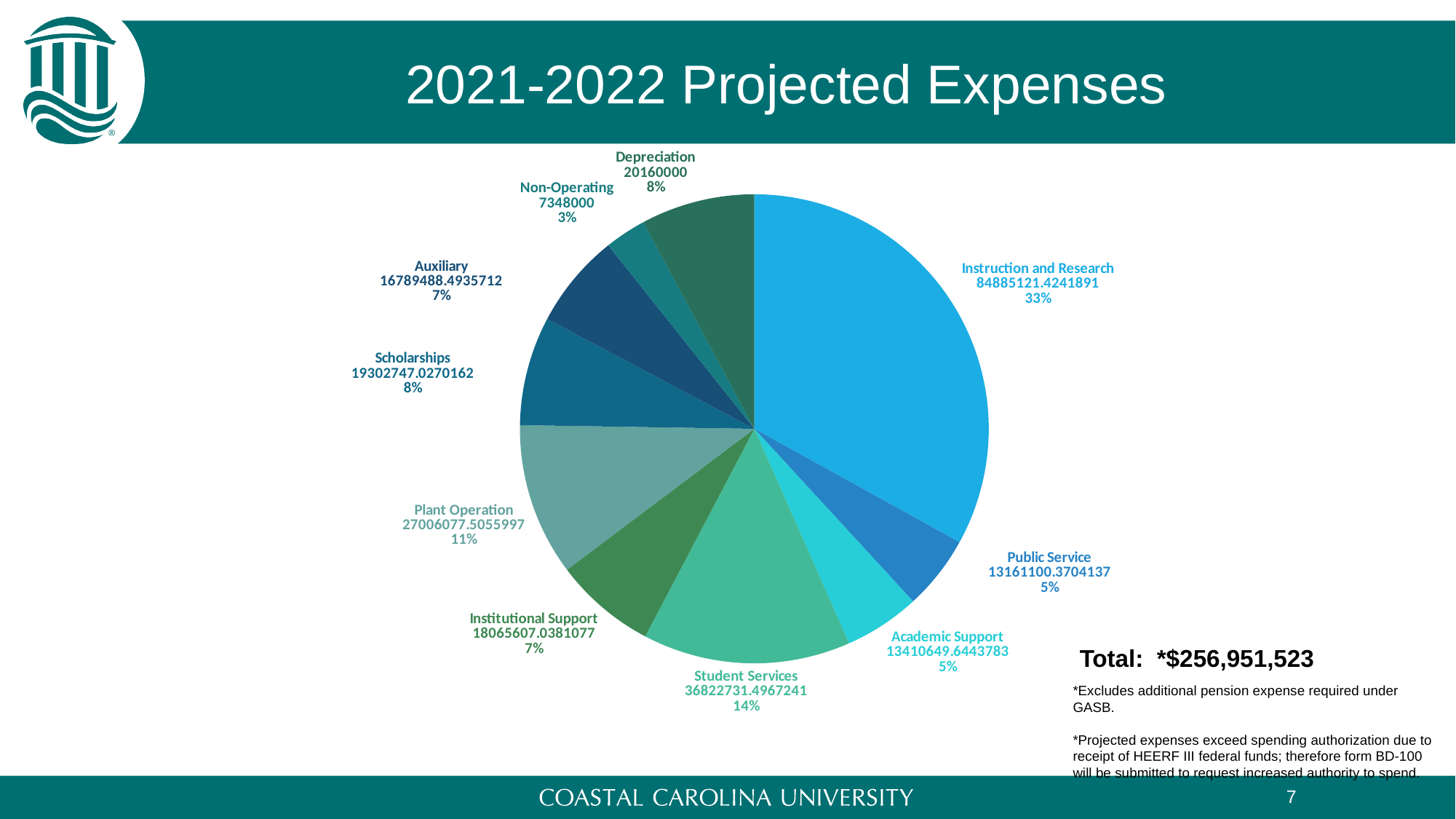
What kind of chart is shown on the slide? Pie chart What share of the pie does Instruction and Research represent? 33% What is the title of the slide containing the pie chart? 2021-2022 Projected Expenses What is the projected expense value for Depreciation? 20160000 What is the projected expense value for Plant Operation? 27006077.5055997 What share of the pie does Student Services represent? 14% Which category has the largest share of projected expenses? Instruction and Research Which category has the smallest share of projected expenses? Non-Operating What is the difference between the Depreciation and Non-Operating values? 12812000 What is the projected expense value for Non-Operating? 7348000 How many categories does the pie chart show? 10 Which is larger, the value for Plant Operation or the value for Scholarships? Plant Operation